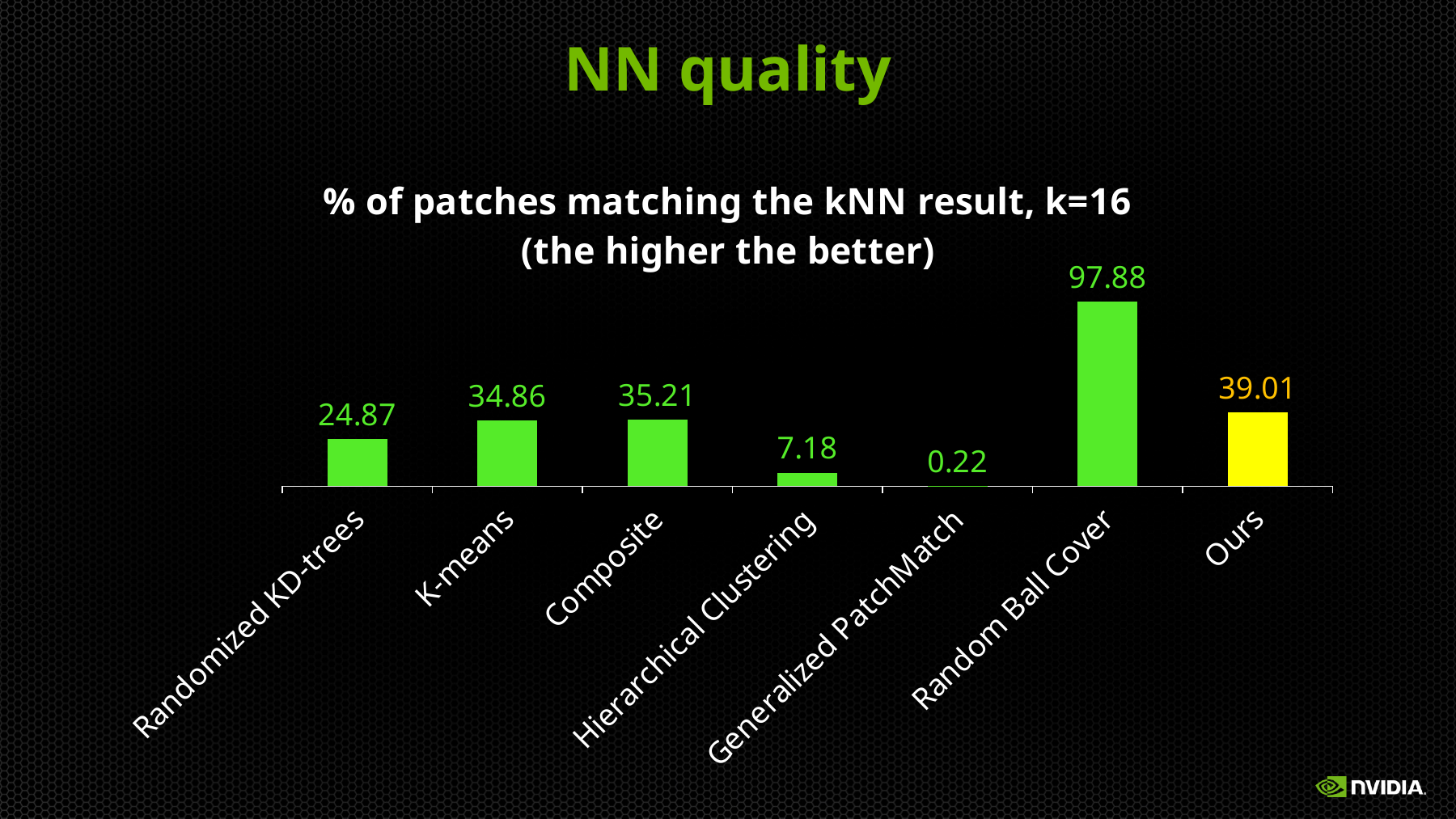
What is the difference between the values for K-means and Randomized KD-trees? 9.99 What kind of chart is shown on the slide? Bar chart Which category has the lowest value? Generalized PatchMatch What is the value for Hierarchical Clustering? 7.18 What is the difference between the values for Random Ball Cover and Ours? 58.87 What is the value for Ours? 39.01 How many categories are shown on the x axis? 7 Which is larger, the value for Ours or the value for Composite? Ours Which category has the highest value? Random Ball Cover Which bar is coloured yellow rather than green? Ours What is the value for Random Ball Cover? 97.88 What is the value for Generalized PatchMatch? 0.22